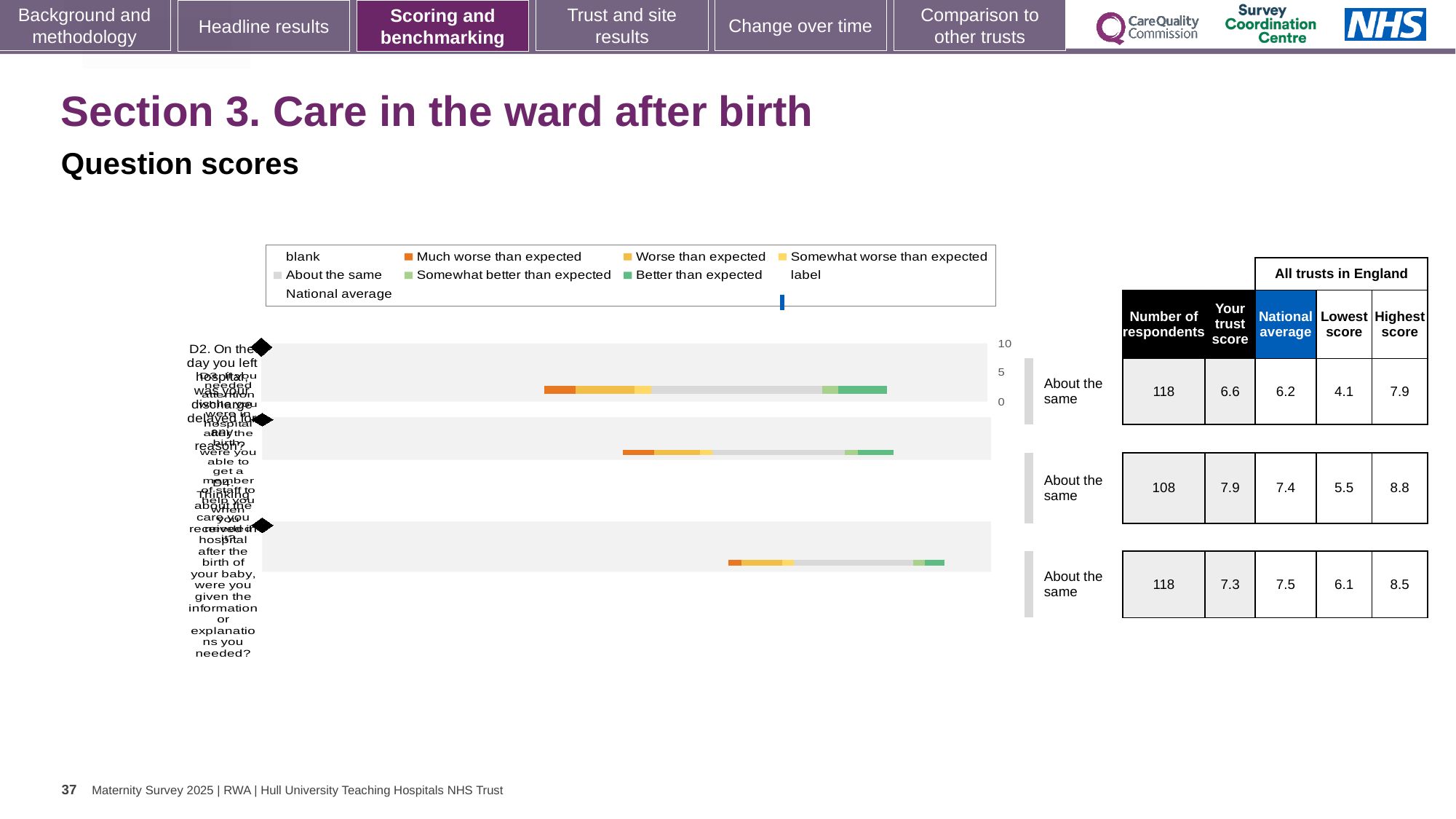
What is the difference between the 'Your trust score' of the middle row (7.9) and the top row (6.6)? 1.3 What is the 'Your trust score' shown for the middle question row in the chart? 7.9 What is the 'Your trust score' shown for the top question row in the chart? 6.6 What is the 'Your trust score' shown for the bottom question row in the chart? 7.3 Which question row has the highest 'Your trust score': top, middle or bottom? middle Is the 'Your trust score' for the middle row larger than the 'National average' for that row? Yes How many respondents are shown for the middle question row? 108 What is the highest value shown on the chart's numeric axis? 10 How many question rows (bars) are plotted in the chart? 3 Which question row has the lowest 'Your trust score': top, middle or bottom? top Which colour does the legend use for 'Much worse than expected'? orange What kind of chart is shown on the slide? bar chart